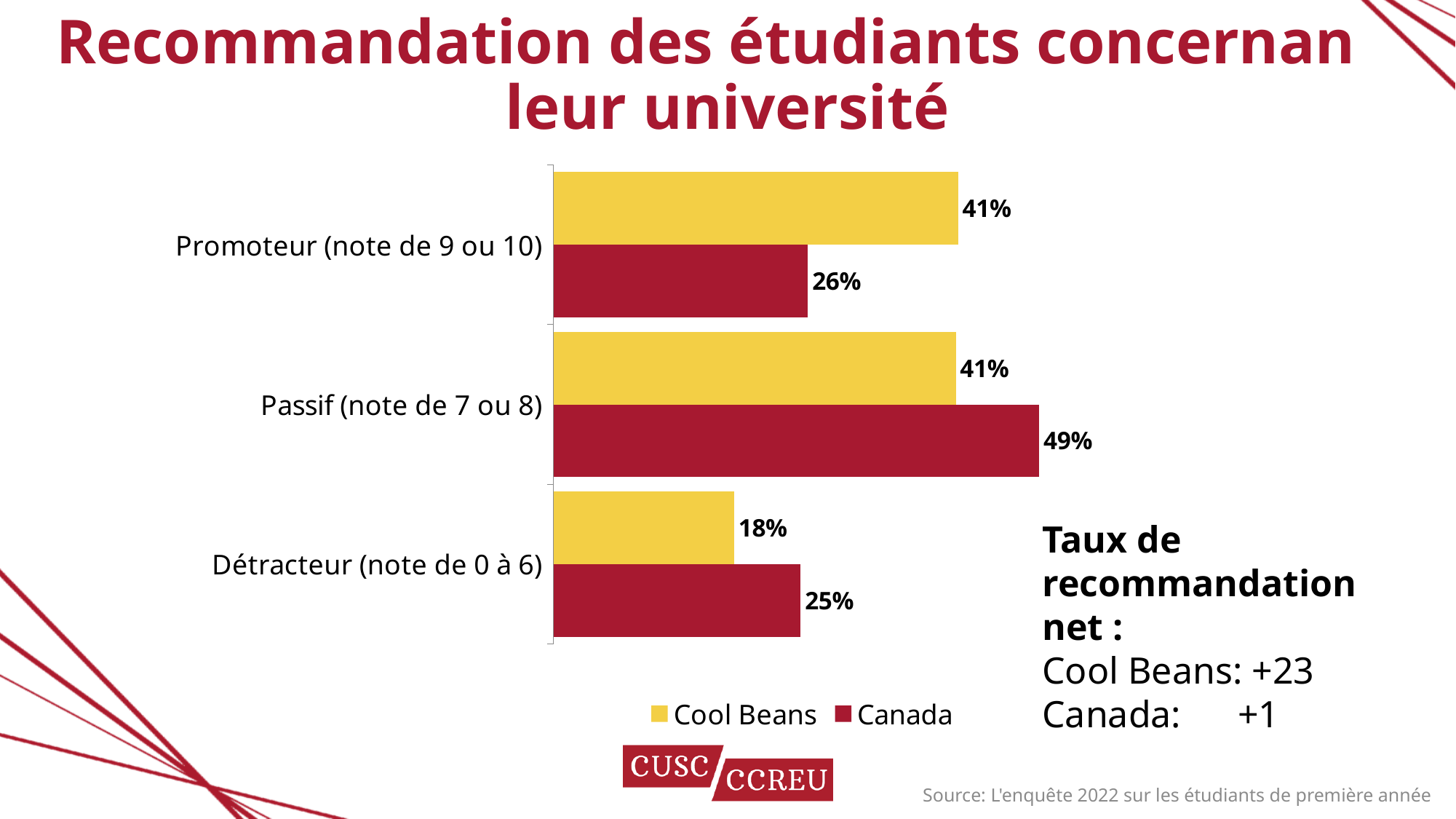
What is the difference between the Cool Beans and Canada values for Promoteur (note de 9 ou 10)? 15% What is the difference between the Canada and Cool Beans values for Détracteur (note de 0 à 6)? 7% What is the Cool Beans value for Détracteur (note de 0 à 6)? 18% Which category has the highest Canada value? Passif (note de 7 ou 8) How many series does the legend list? 2 What is the Canada value for Passif (note de 7 ou 8)? 49% Which category has the lowest Cool Beans value? Détracteur (note de 0 à 6) How many categories are shown on the chart? 3 What is the Cool Beans value for Promoteur (note de 9 ou 10)? 41% For Passif (note de 7 ou 8), which series has the larger value, Cool Beans or Canada? Canada What kind of chart is shown on the slide? Bar chart What is the Canada value for Promoteur (note de 9 ou 10)? 26%